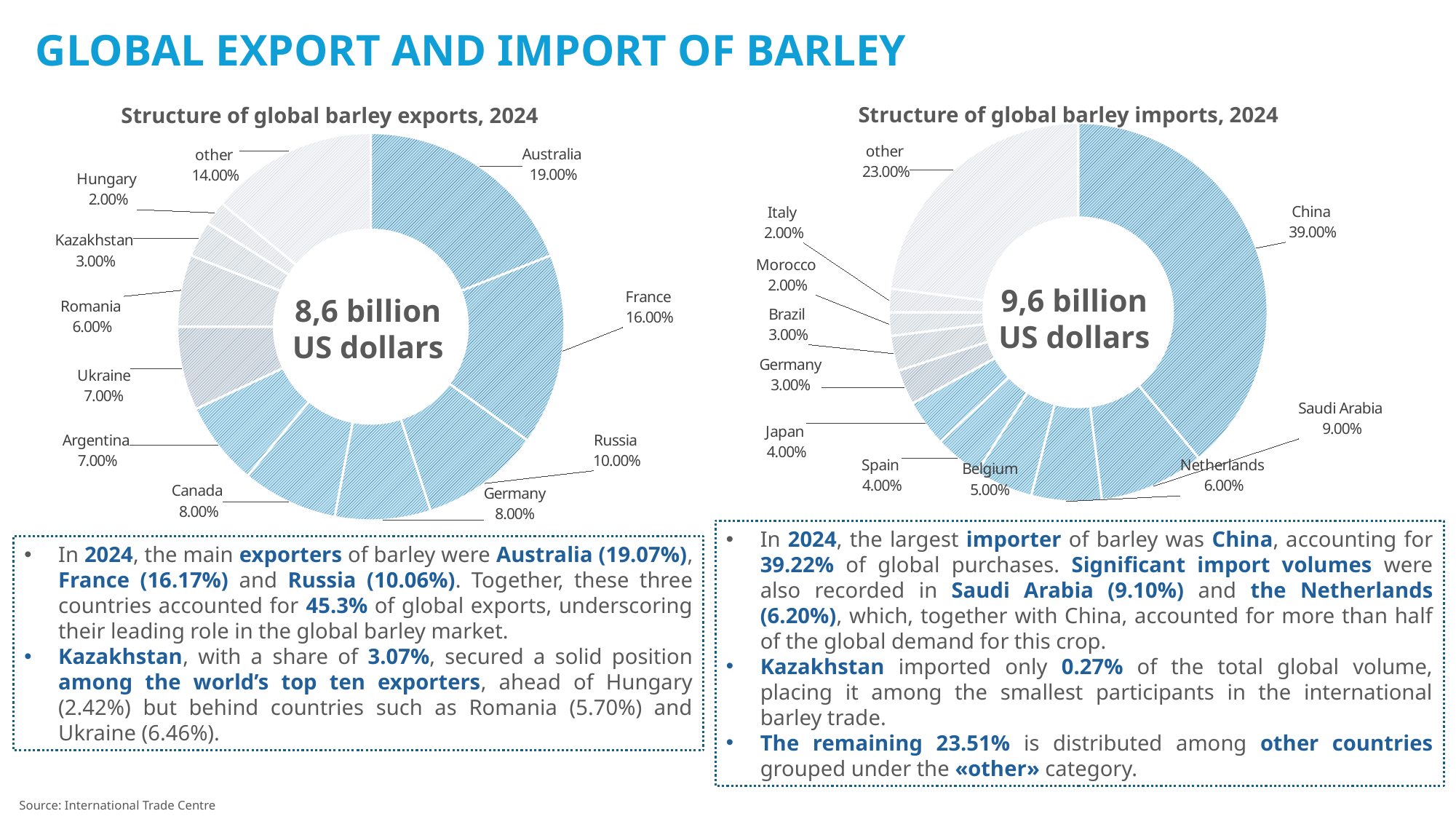
In the 'Structure of global barley exports, 2024' chart, what is the difference between the shares of France and Russia? 6.00% In the 'Structure of global barley exports, 2024' chart, which named country has the smallest share? Hungary In the 'Structure of global barley exports, 2024' chart, what share does Australia have? 19.00% In the 'Structure of global barley imports, 2024' chart, what is the combined share of Spain and Japan? 8.00% In the 'Structure of global barley imports, 2024' chart, which country has the largest share? China What total value is shown in the centre of the 'Structure of global barley imports, 2024' chart? 9,6 billion US dollars What total value is shown in the centre of the 'Structure of global barley exports, 2024' chart? 8,6 billion US dollars In the 'Structure of global barley exports, 2024' chart, what share does Kazakhstan have? 3.00% How many slices does the 'Structure of global barley exports, 2024' chart have? 11 In the 'Structure of global barley imports, 2024' chart, which is larger, the share of Saudi Arabia or the share of the Netherlands? Saudi Arabia What kind of chart is the 'Structure of global barley imports, 2024' chart? Donut (pie) chart In the 'Structure of global barley imports, 2024' chart, what share does China have? 39.00%